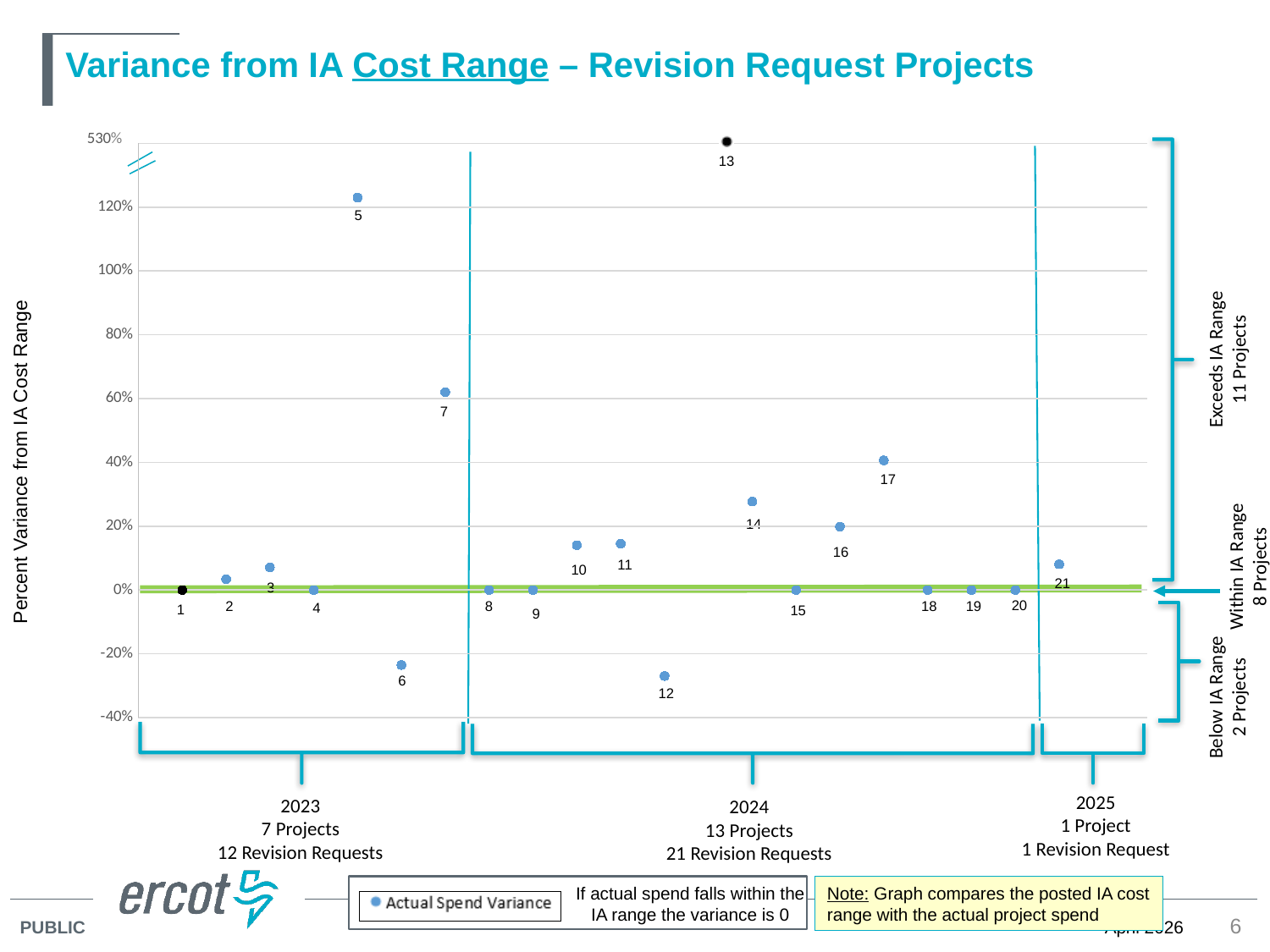
Is the value for project 7 greater or less than 40%? greater How many series does the legend list? 1 Is the value for project 12 greater or less than -20%? less What is the percent variance for project 13? 530% Which has the larger percent variance, project 17 or project 14? Project 17 Is the value for project 5 greater or less than 100%? greater How many data points are plotted on the chart? 21 Which project number has the highest percent variance from IA cost range? 13 What type of chart is shown on the slide? Scatter chart According to the annotation on the right of the chart, how many projects exceed the IA range? 11 Projects Which project number has the lowest percent variance from IA cost range? 12 What is the title of the vertical axis? Percent Variance from IA Cost Range